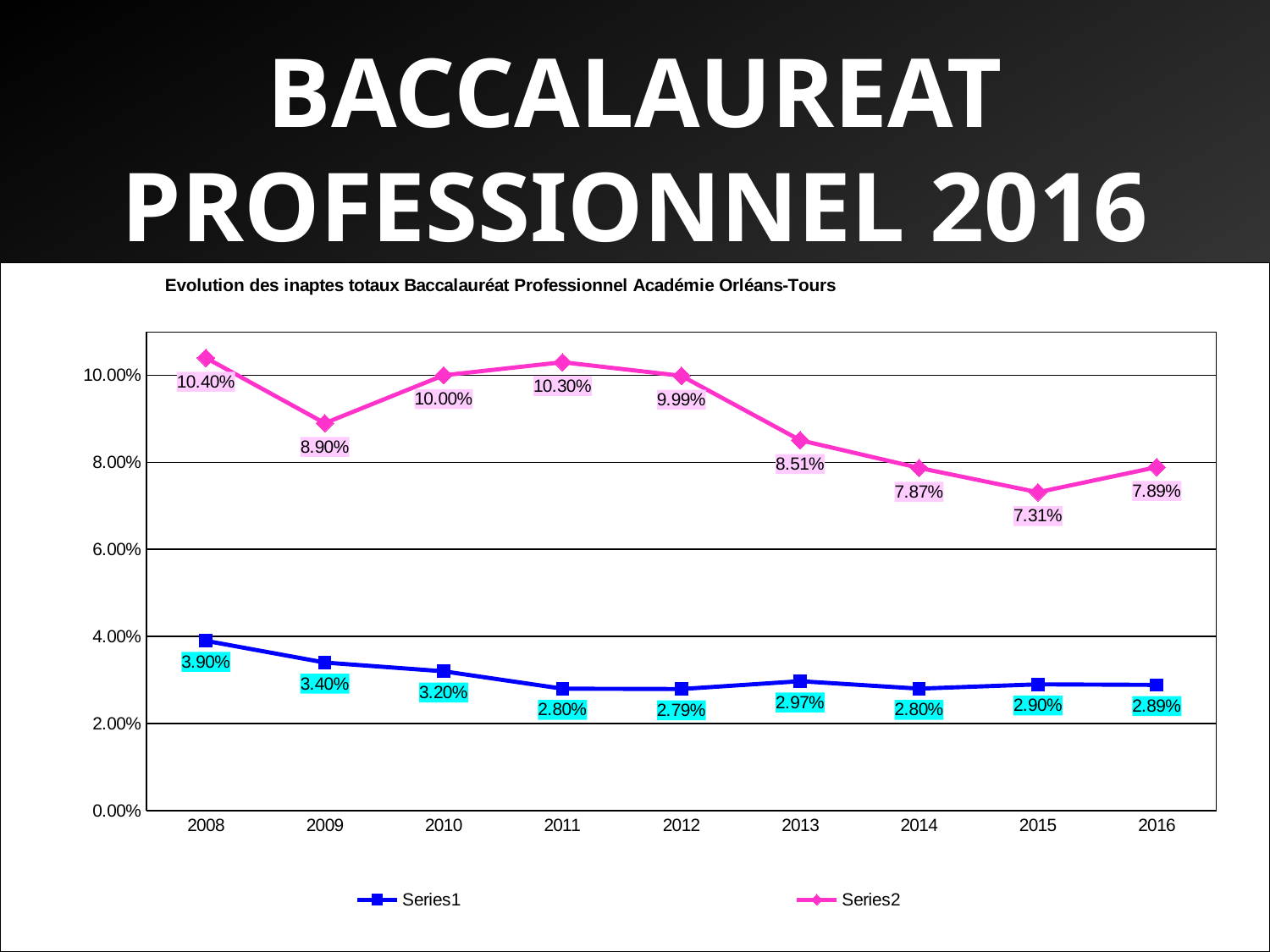
Which is larger, Series1 in 2008 or Series1 in 2011? Series1 in 2008 How many years are shown on the x axis? 9 In which year is Series1 at its highest? 2008 What is the value of Series1 in 2012? 2.79% In which year is Series2 at its lowest? 2015 What is the value of Series2 in 2015? 7.31% What is the value of Series2 in 2008? 10.40% What type of chart is shown on the slide? Line chart In which year is Series2 at its highest? 2008 How many series does the legend list? 2 What is the title of the chart? Evolution des inaptes totaux Baccalauréat Professionnel Académie Orléans-Tours What is the difference between Series2 and Series1 in 2016? 5.00%